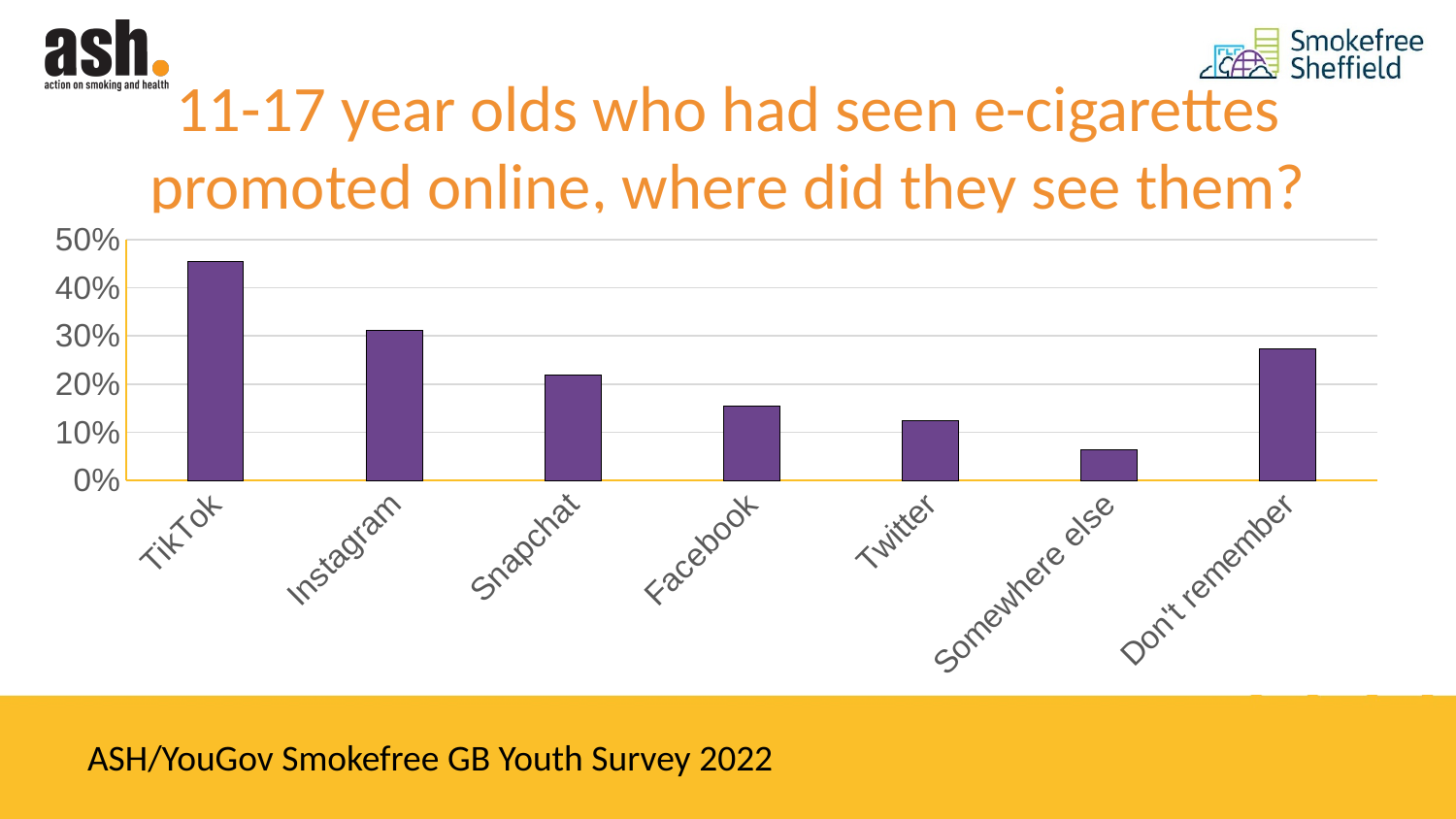
Is the value for Instagram greater or less than 40%? less Which category has the lowest value? Somewhere else Which category has the highest value? TikTok Is the value for Facebook greater or less than 20%? less How many categories are shown on the x axis of the chart? 7 Is the value for TikTok greater or less than 40%? greater Which is larger, the value for Instagram or the value for Don't remember? Instagram What is the title of the chart? 11-17 year olds who had seen e-cigarettes promoted online, where did they see them? What kind of chart is shown on the slide? bar chart Which is larger, the value for Snapchat or the value for Twitter? Snapchat